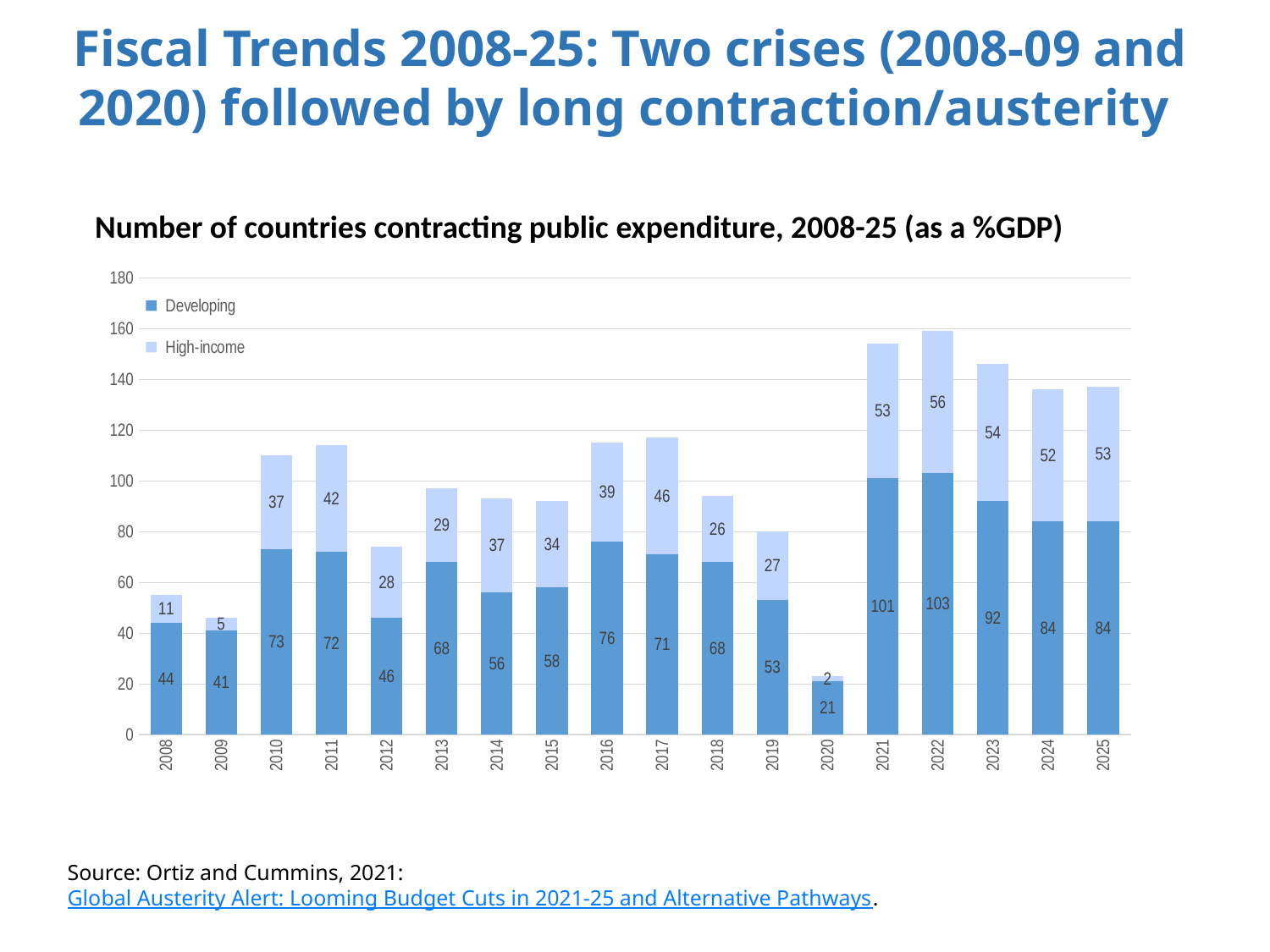
How many series does the legend list? 2 What is the value for Developing countries in 2022? 103 How many years are shown on the x axis? 18 What type of chart is shown on the slide? Stacked bar chart Which is larger, the Developing value in 2016 or in 2018? 2016 What is the title of the chart? Number of countries contracting public expenditure, 2008-25 (as a %GDP) What is the total number of countries contracting public expenditure in 2021? 154 Which year has the highest value for High-income countries? 2022 What is the value for High-income countries in 2017? 46 Is the total stacked bar for 2012 greater or less than 80? less What is the difference between the Developing values for 2022 and 2020? 82 Which year has the lowest value for Developing countries? 2020